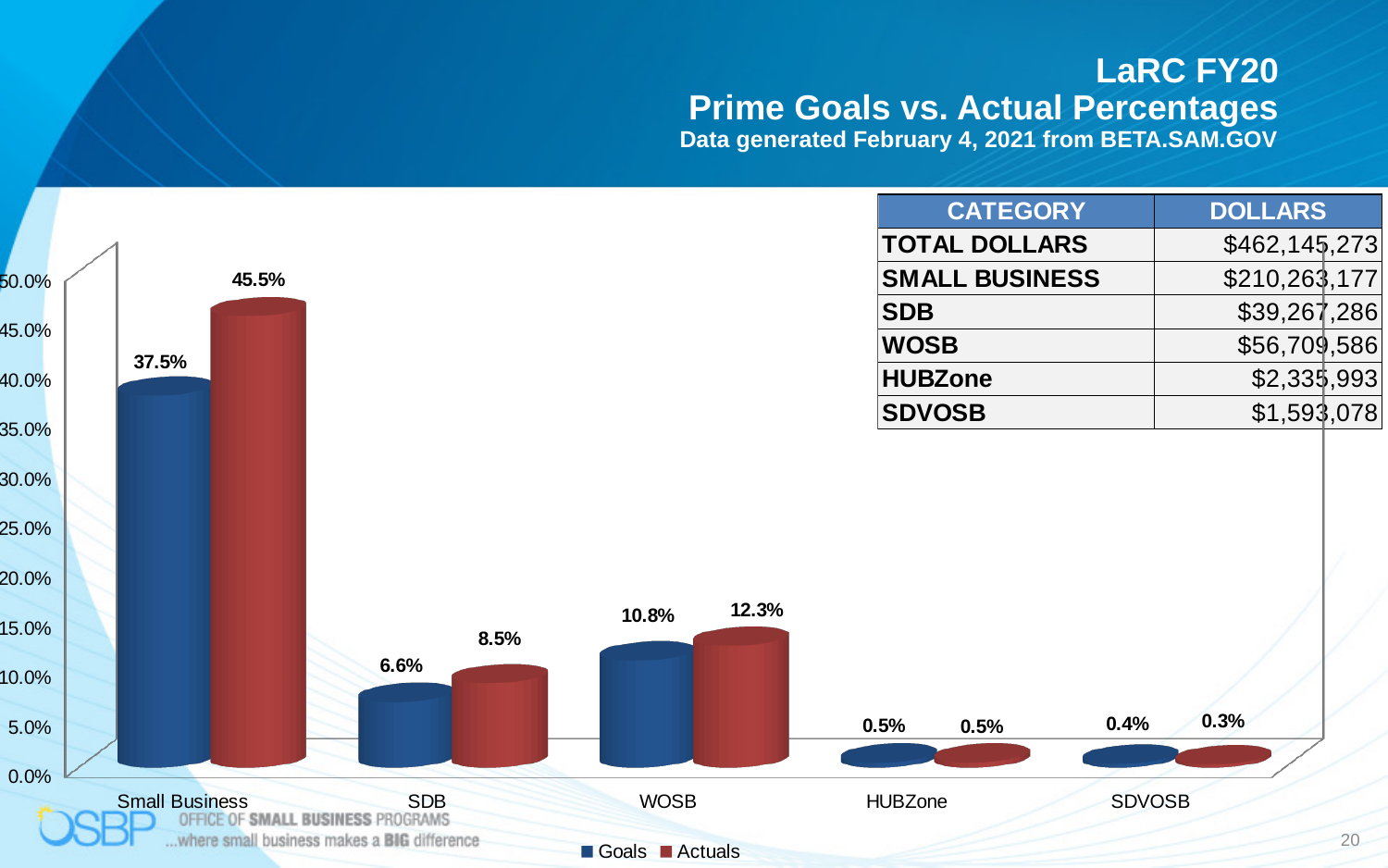
Which category has the lowest Actuals value? SDVOSB Which is larger for WOSB, the Goals value or the Actuals value? Actuals What is the Goals value for SDVOSB? 0.4% Is the Goals value for Small Business greater or less than 35.0%? greater How many series does the chart legend list? 2 What kind of chart is shown on the slide? Bar chart What is the Actuals value for Small Business? 45.5% How many categories are shown on the x axis of the chart? 5 Which category has the highest Actuals value? Small Business What is the difference between the Actuals and Goals values for Small Business? 8.0% What is the Actuals value for SDB? 8.5% What is the Goals value for WOSB? 10.8%